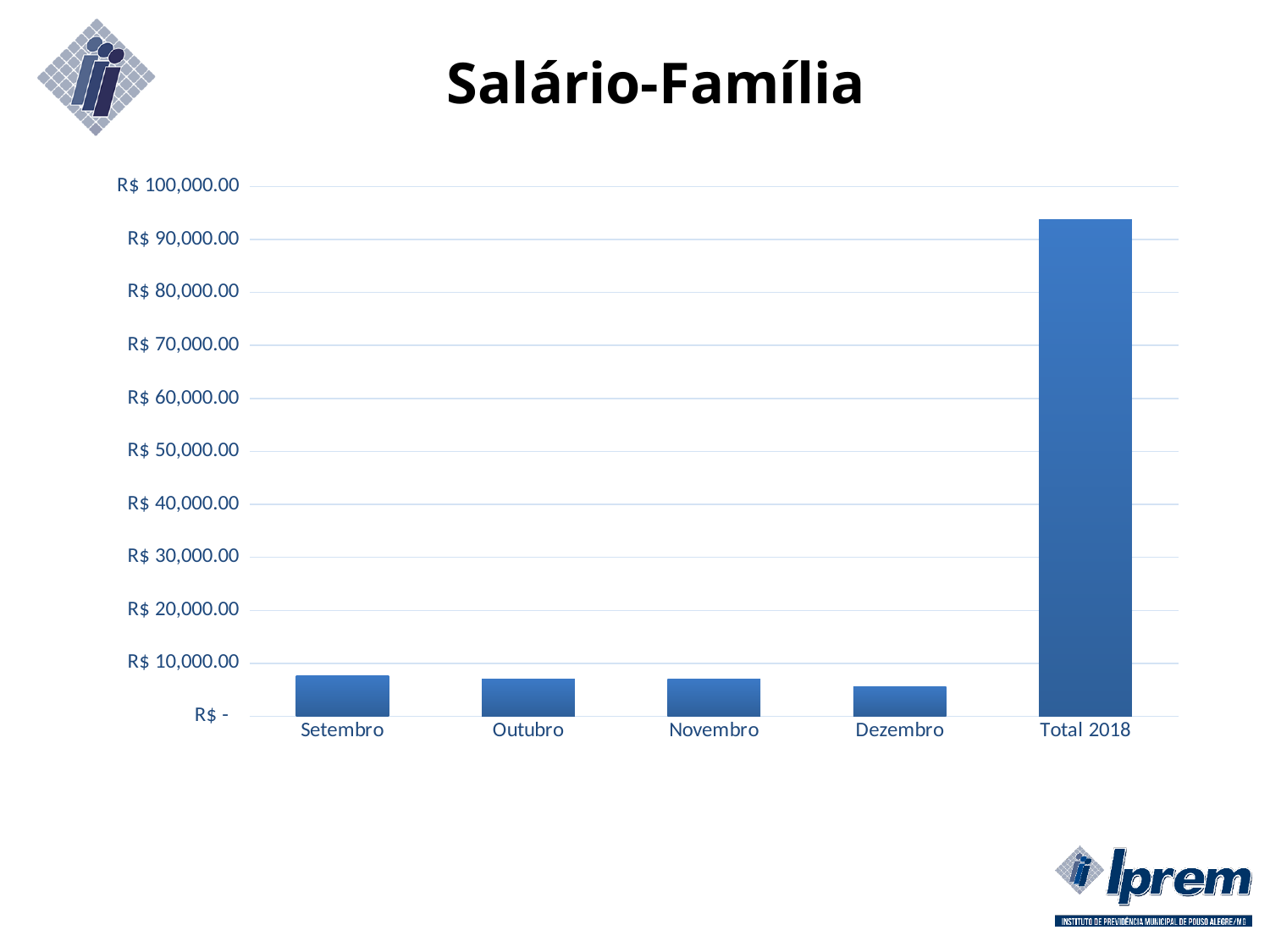
How many categories are shown on the x axis of the chart? 5 Is the value for Dezembro greater or less than R$ 10,000.00? less Which category has the highest value in the chart? Total 2018 Is the value for Total 2018 greater or less than R$ 90,000.00? greater Which is larger, the value for Setembro or the value for Dezembro? Setembro Is the value for Total 2018 greater or less than R$ 100,000.00? less Which month among Setembro, Outubro, Novembro and Dezembro has the highest value? Setembro Which category has the lowest value in the chart? Dezembro What kind of chart is shown on the slide? bar chart Which is larger, the value for Total 2018 or the value for Novembro? Total 2018 What is the title of the chart? Salário-Família